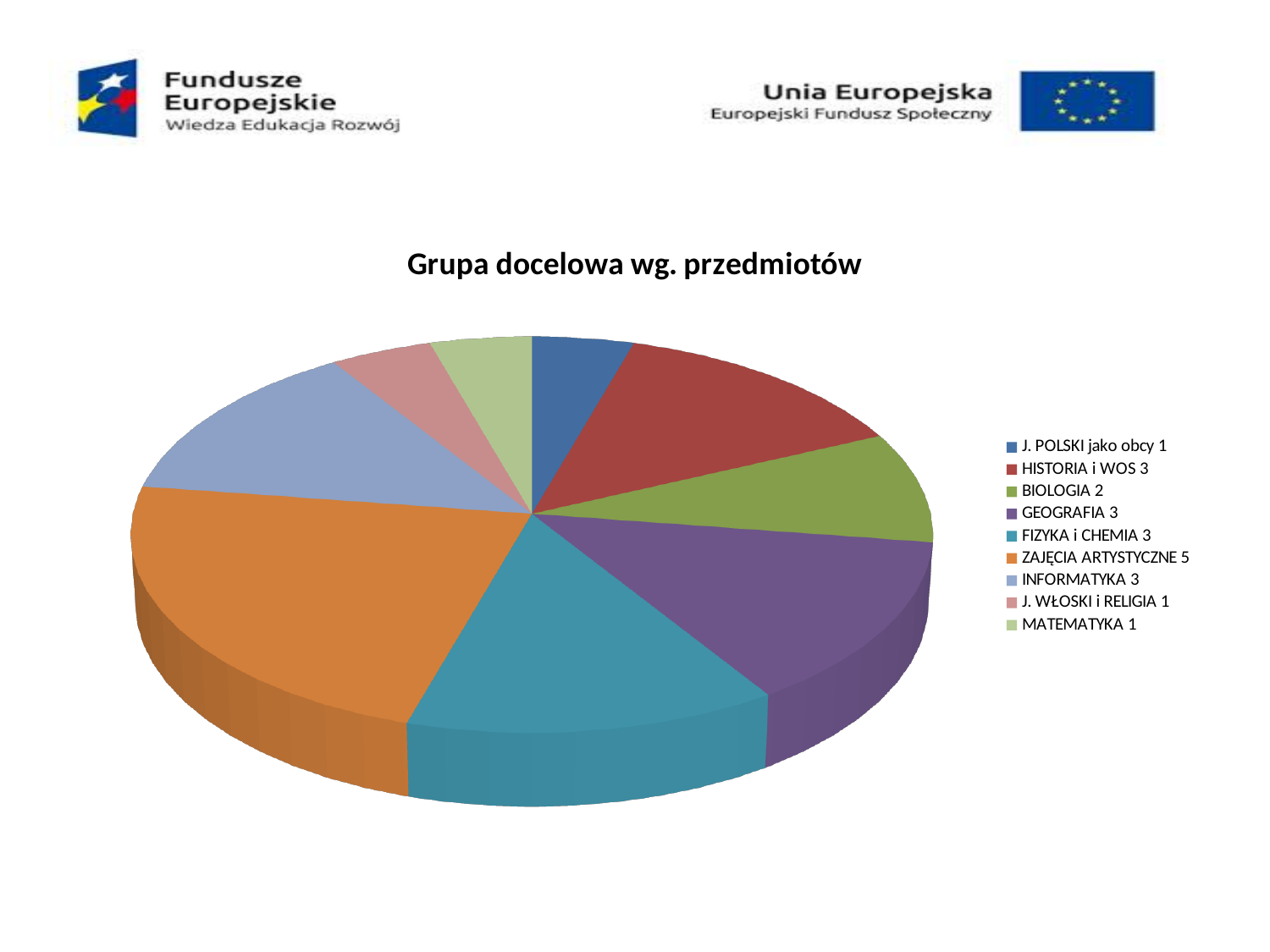
What is the value for J. POLSKI jako obcy? 1 What is the value for FIZYKA i CHEMIA? 3 What is the difference between the values for ZAJĘCIA ARTYSTYCZNE and INFORMATYKA? 2 What type of chart is shown on the slide? Pie chart What is the value for BIOLOGIA? 2 Which category has the highest value? ZAJĘCIA ARTYSTYCZNE What is the difference between the values for GEOGRAFIA and MATEMATYKA? 2 Which is larger, HISTORIA i WOS or BIOLOGIA? HISTORIA i WOS What is the title of the chart? Grupa docelowa wg. przedmiotów How many categories does the pie chart have? 9 What is the value for ZAJĘCIA ARTYSTYCZNE? 5 What colour is the slice for ZAJĘCIA ARTYSTYCZNE? Orange